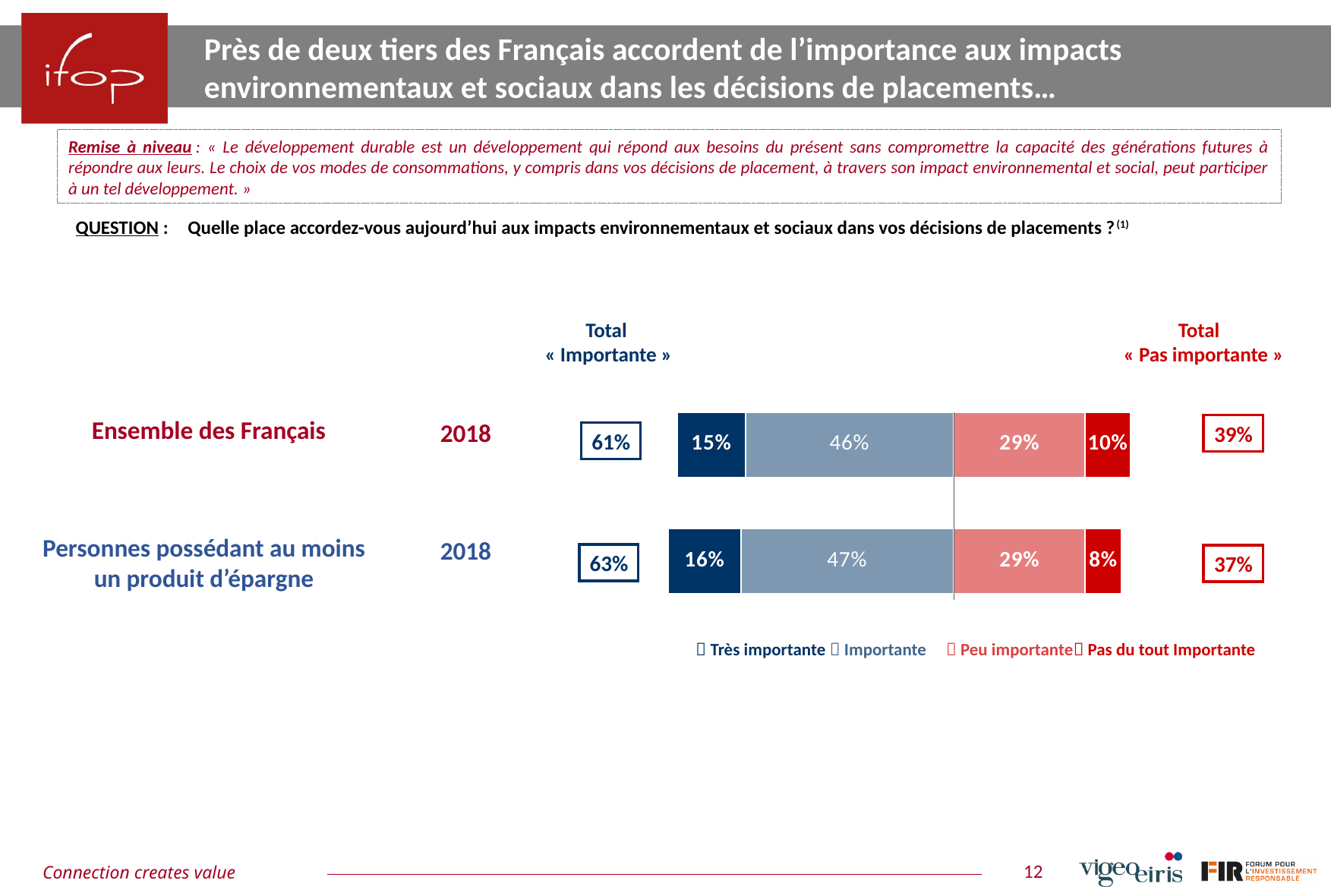
What is the total of the 'Très importante' and 'Importante' segments for 'Ensemble des Français'? 61% Which response category has the smallest share for 'Personnes possédant au moins un produit d'épargne'? Pas du tout Importante What percentage of 'Ensemble des Français' answered 'Très importante'? 15% How many series does the legend list? 4 What is the 'Total « Importante »' value for 'Personnes possédant au moins un produit d'épargne'? 63% What is the difference between the 'Pas du tout Importante' shares of 'Ensemble des Français' and 'Personnes possédant au moins un produit d'épargne'? 2% What kind of chart is shown on the slide? Stacked bar chart Which group has the higher 'Très importante' share, 'Ensemble des Français' or 'Personnes possédant au moins un produit d'épargne'? Personnes possédant au moins un produit d'épargne Which response category has the largest share for 'Ensemble des Français'? Importante What percentage of 'Personnes possédant au moins un produit d'épargne' answered 'Importante'? 47% What is the 'Total « Pas importante »' value for 'Ensemble des Français'? 39% What percentage of 'Ensemble des Français' answered 'Pas du tout Importante'? 10%